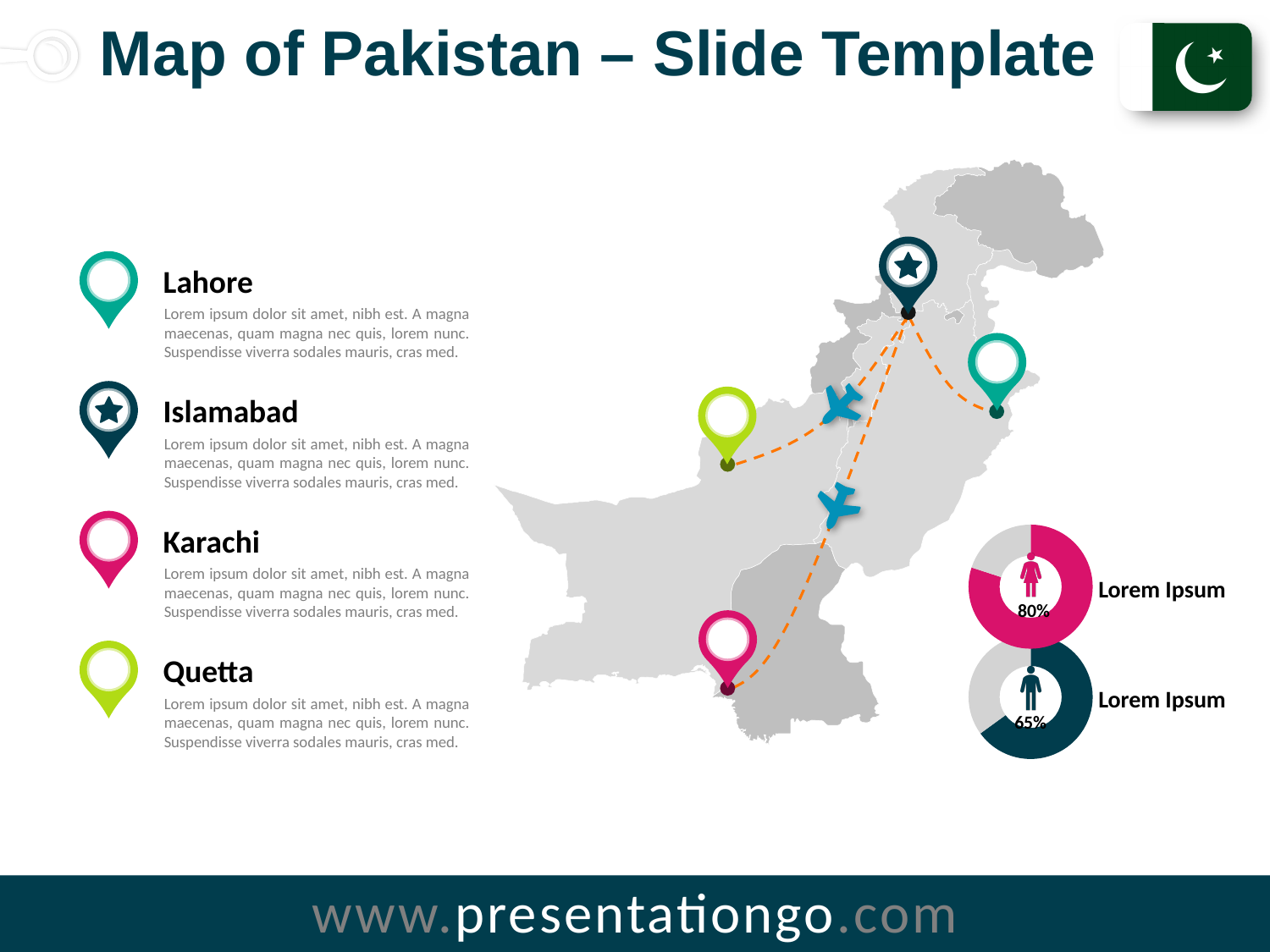
What colour is the filled portion of the upper donut chart? Pink (magenta) What is the difference between the percentage in the upper donut chart and the percentage in the lower donut chart? 15 percentage points Which donut chart shows the larger percentage, the upper pink one or the lower dark blue one? The upper pink one How many donut charts are shown on the slide? 2 What percentage is shown in the lower donut chart (the dark blue one with the male icon)? 65% What percentage is shown in the upper donut chart (the pink one with the female icon)? 80% What kind of chart are the two circular graphics at the lower right of the slide? Donut (pie) charts Is the value shown in the lower donut chart greater or less than 70%? less What label appears next to each of the two donut charts? Lorem Ipsum Is the value shown in the upper donut chart greater or less than 50%? greater